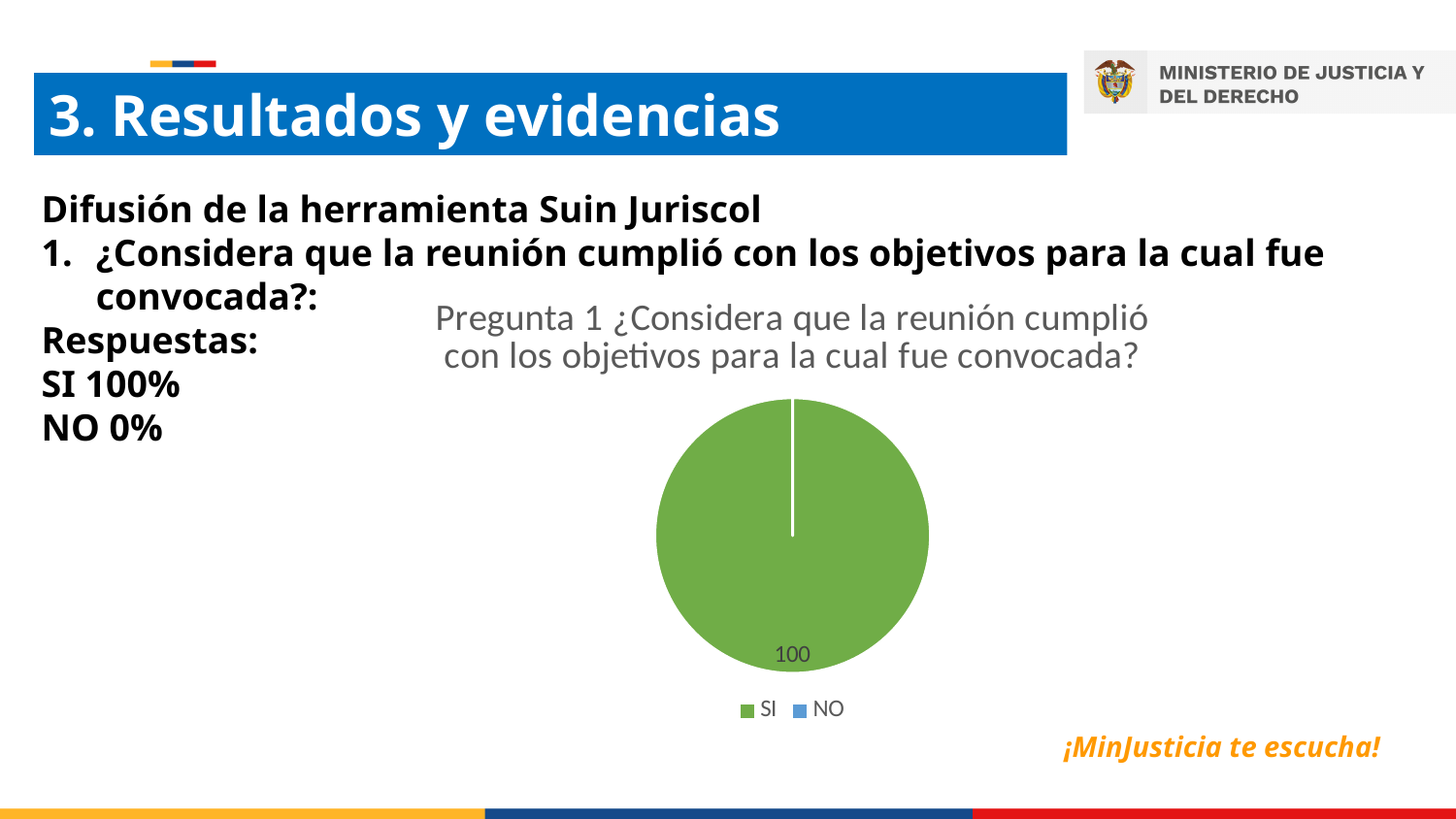
Which category has the smallest share in the pie chart? NO How many series does the legend of the pie chart list? 2 Is the value for SI in the pie chart greater or less than 50? greater Which is larger in the pie chart, SI or NO? SI What colour is the SI slice in the pie chart? green What is the title of the pie chart? Pregunta 1 ¿Considera que la reunión cumplió con los objetivos para la cual fue convocada? What is the data label shown on the SI slice of the pie chart? 100 What share of the pie does the SI slice take up? 100% Which category has the largest slice in the pie chart? SI What kind of chart is shown on the slide? pie chart